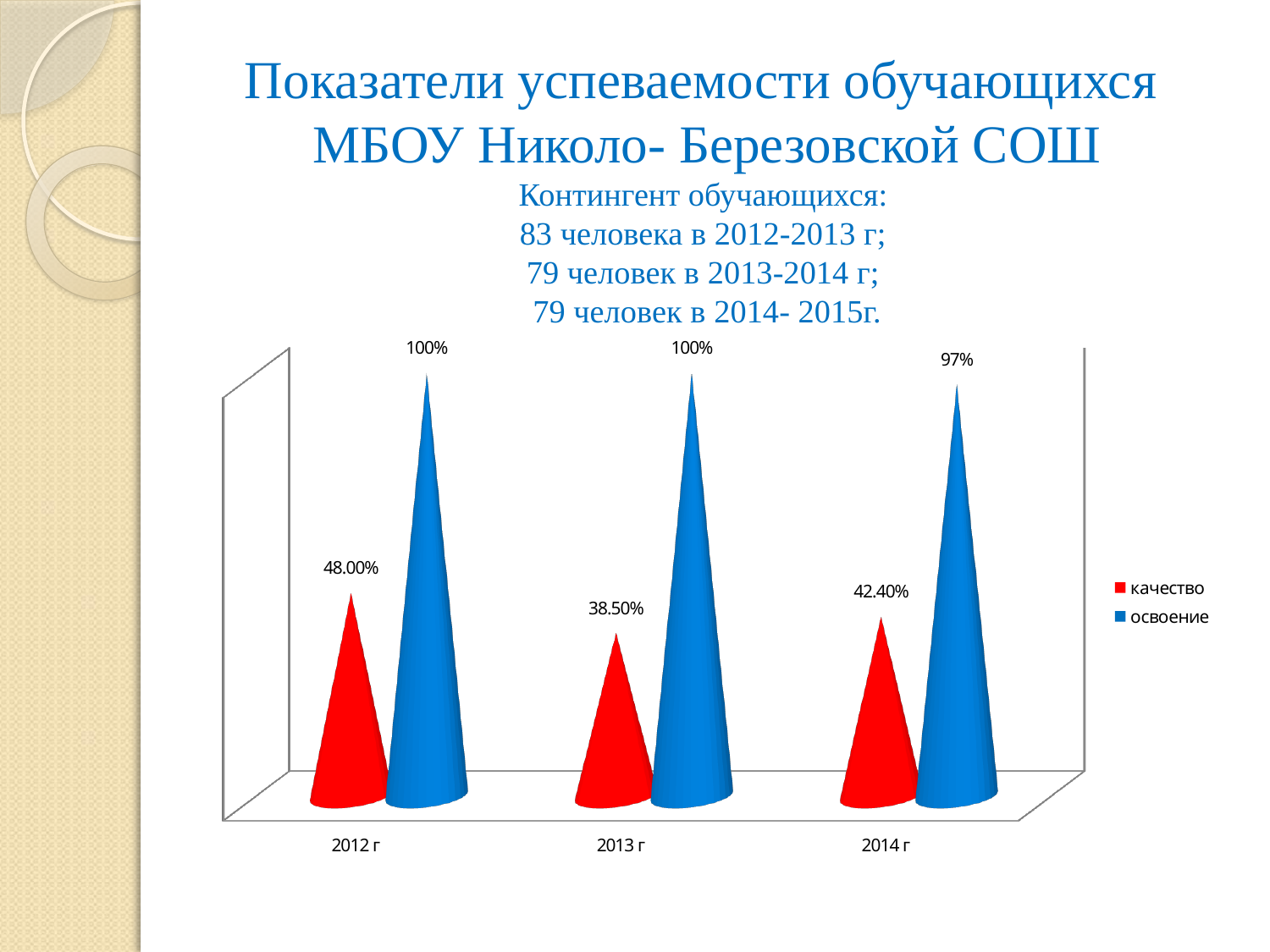
What is the value of освоение for 2013 г? 100% What is the value of качество for 2012 г? 48.00% What is the difference between the качество values for 2012 г and 2013 г? 9.50% Which is larger for 2014 г: качество or освоение? освоение What is the value of качество for 2013 г? 38.50% Which year has the highest качество value? 2012 г How many years are shown on the x axis? 3 Which year has the lowest качество value? 2013 г How many series does the legend list? 2 What is the value of освоение for 2014 г? 97% Which colour represents the освоение series? blue What kind of chart is shown on the slide? bar chart